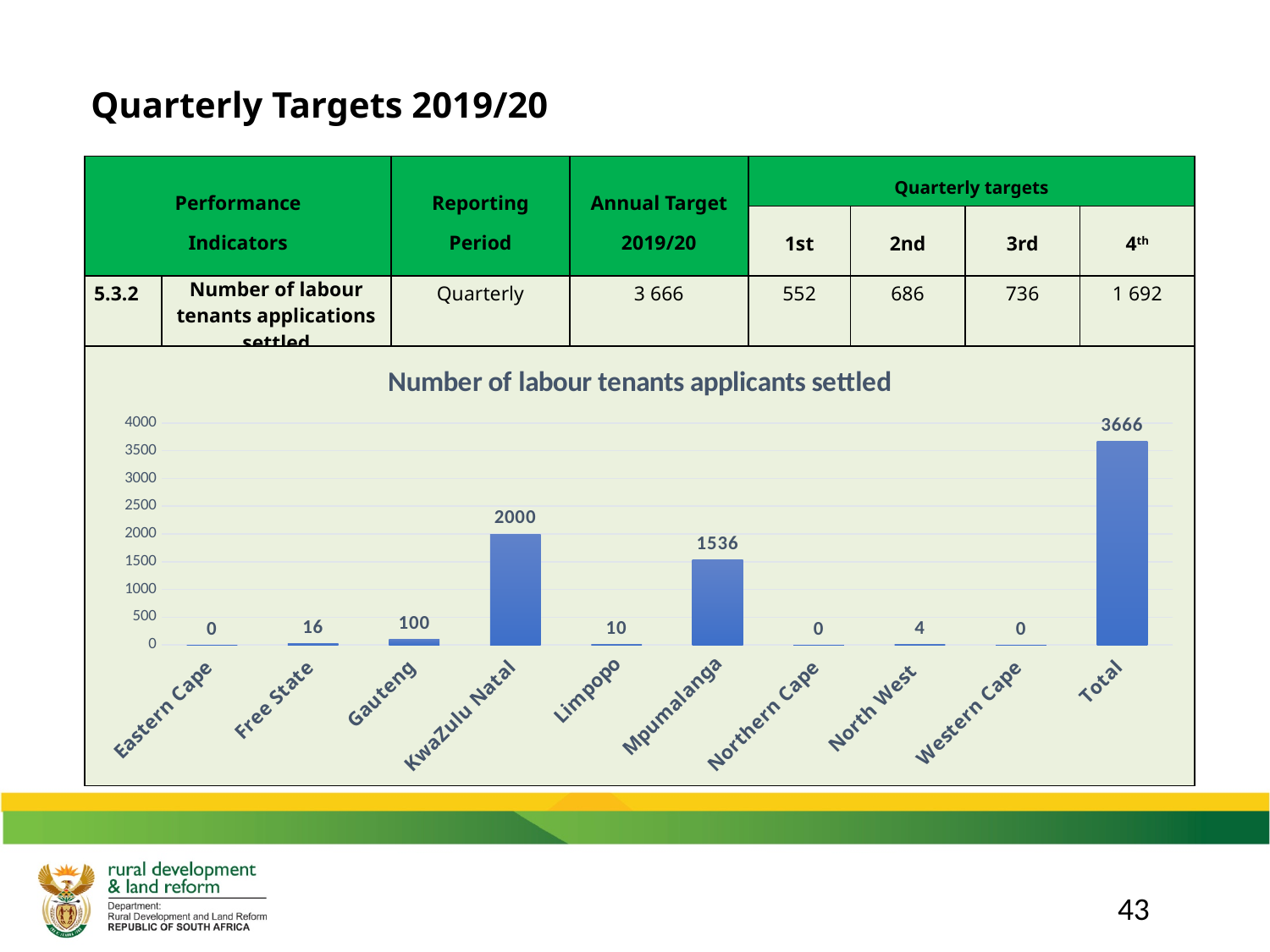
Which is larger, the value for Gauteng or the value for Limpopo? Gauteng What is the value for Mpumalanga in the chart? 1536 What is the value shown for Total in the chart? 3666 What is the value for KwaZulu Natal in the chart? 2000 What is the value for Gauteng in the chart? 100 What is the title of the chart? Number of labour tenants applicants settled What is the difference between the values for KwaZulu Natal and Mpumalanga? 464 How many categories are shown on the x axis of the chart? 10 What is the value for Free State in the chart? 16 Which provinces have a value of 0 in the chart? Eastern Cape, Northern Cape, Western Cape What kind of chart is shown on the slide? Bar chart Excluding the Total bar, which province has the highest value? KwaZulu Natal